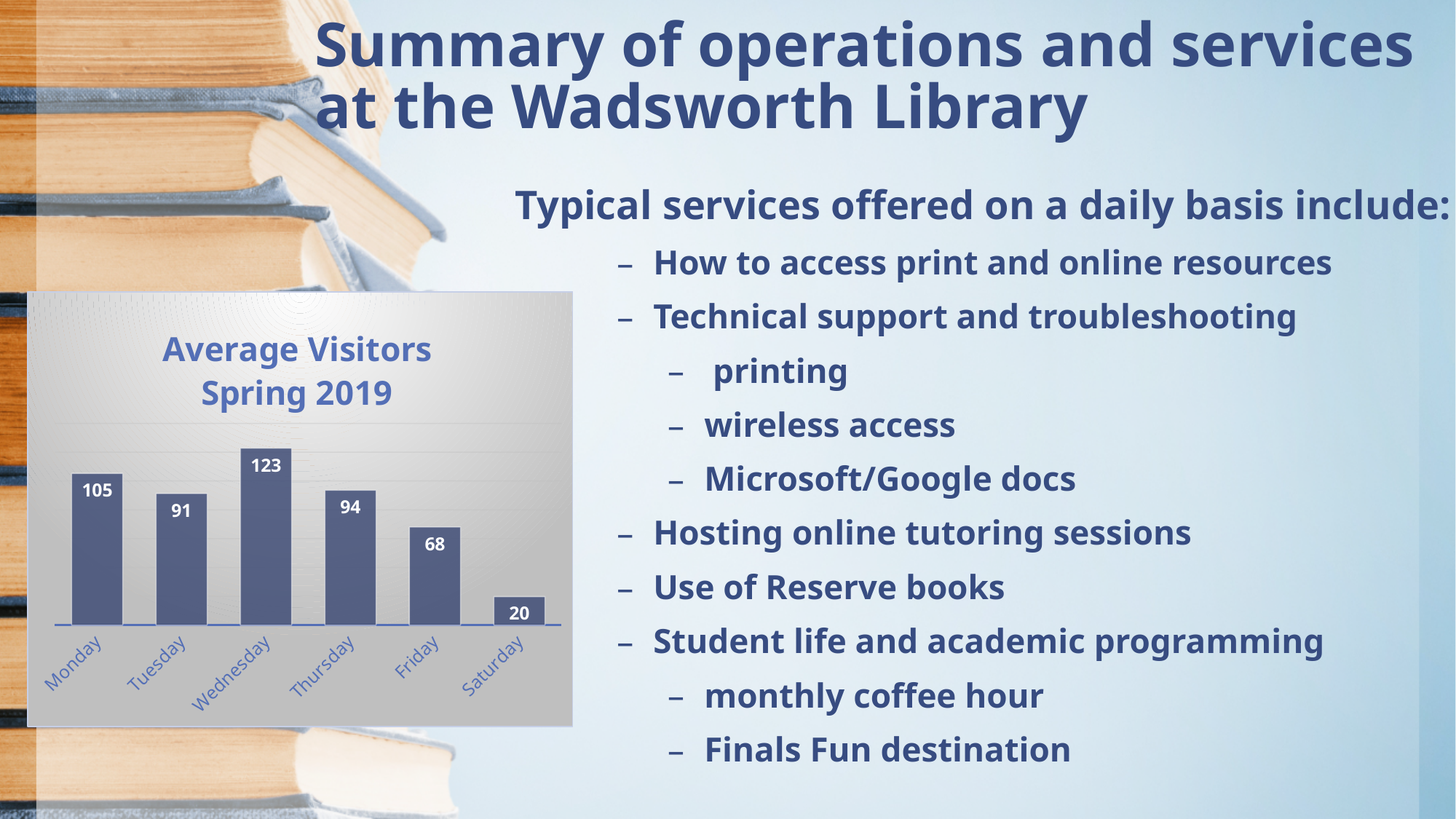
Which day has the highest average number of visitors? Wednesday Which day has the lowest average number of visitors? Saturday What is the average number of visitors on Monday? 105 What is the title of the chart? Average Visitors Spring 2019 What kind of chart is shown on the slide? Bar chart Which day has more average visitors, Thursday or Friday? Thursday How many days are shown in the chart? 6 What is the average number of visitors on Wednesday? 123 Do the average visitor values rise or fall from Wednesday to Saturday? Fall What is the difference in average visitors between Wednesday and Saturday? 103 What is the average number of visitors on Saturday? 20 What is the difference in average visitors between Monday and Tuesday? 14